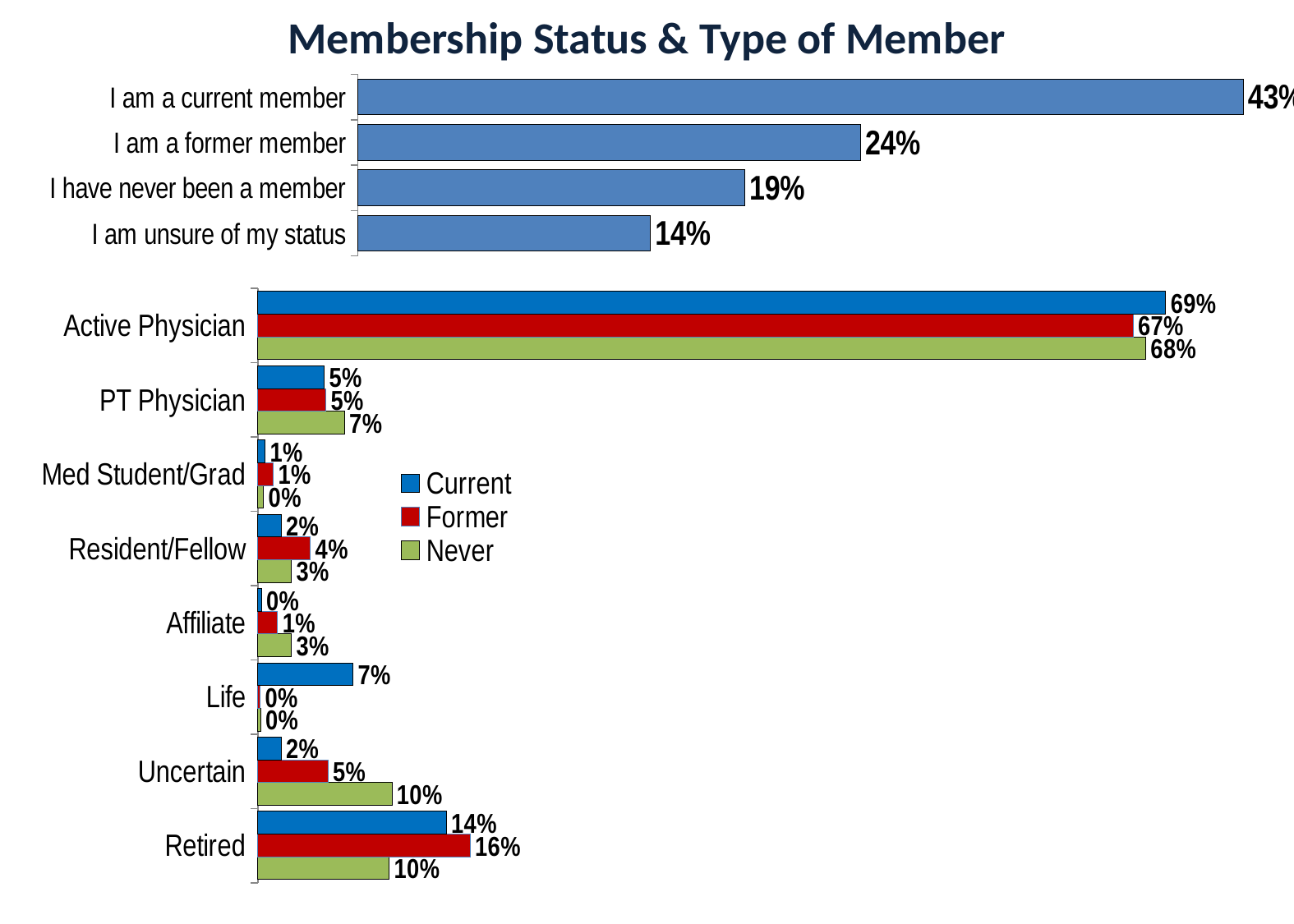
In the bottom chart, which member type has the highest Current value? Active Physician In the bottom chart, what is the difference between the Current and Never values for Active Physician? 1% How many member types does the bottom chart show? 8 How many series does the legend of the bottom chart list? 3 In the top chart, what is the difference between "I am a former member" and "I have never been a member"? 5% In the bottom chart, what is the Never value for Uncertain? 10% In the bottom chart, which is larger for Life: the Current value or the Former value? Current In the top chart, what percentage of respondents said "I am a current member"? 43% In the top chart, which membership status has the lowest percentage? I am unsure of my status How many categories does the top chart show? 4 What type of chart is the bottom chart? Bar chart In the bottom chart, what is the Former value for Retired? 16%